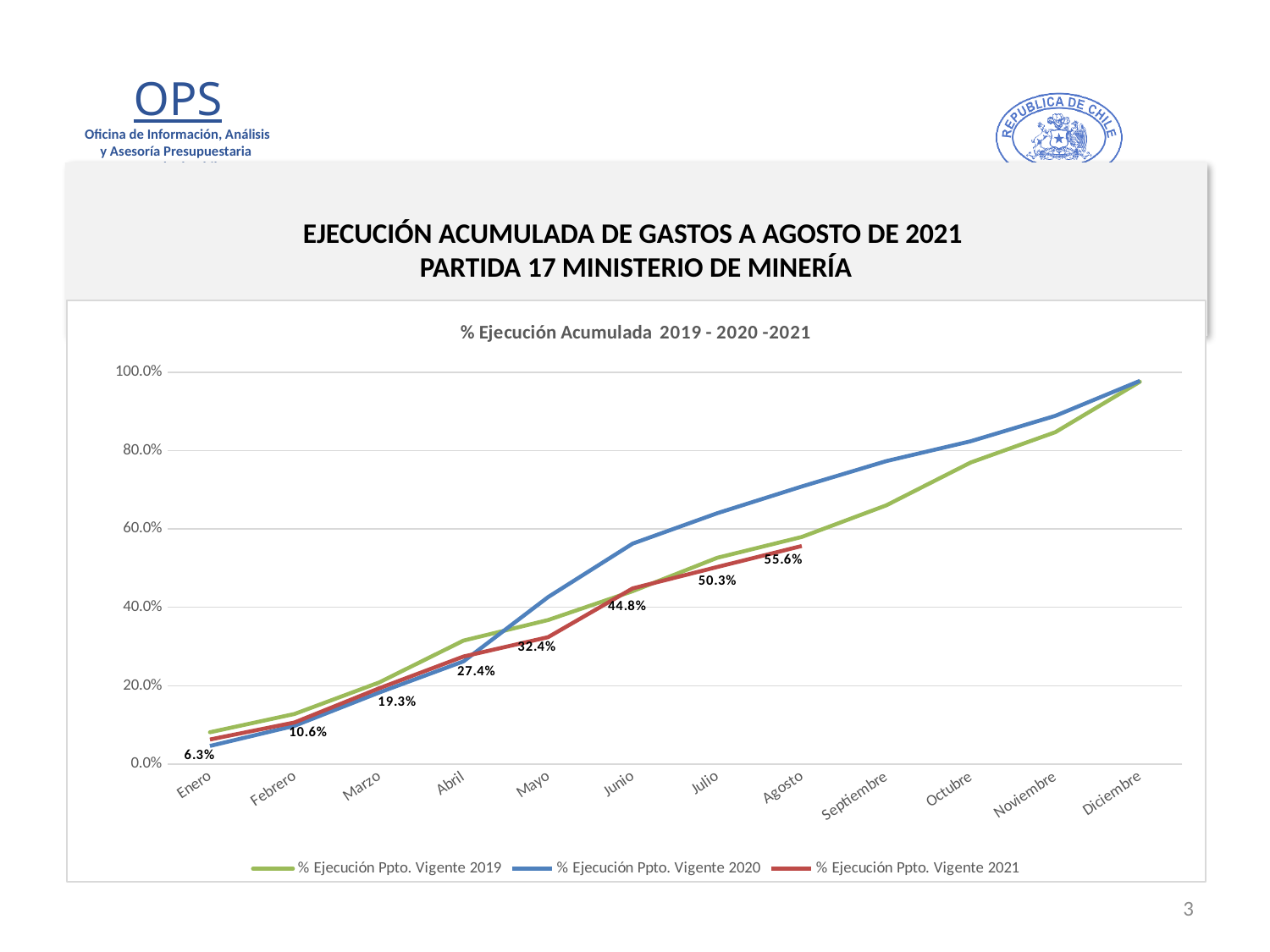
What is the difference between the 2021 values for Junio and Mayo? 12.4 percentage points What is the value for % Ejecución Ppto. Vigente 2021 in Marzo? 19.3% What is the value for % Ejecución Ppto. Vigente 2021 in Mayo? 32.4% What kind of chart is shown on the slide? Line chart Among the labelled 2021 values, which month has the highest value? Agosto Is the value for % Ejecución Ppto. Vigente 2020 in Junio greater or less than 40%? greater What is the value for % Ejecución Ppto. Vigente 2021 in Enero? 6.3% How many series does the legend list? 3 How many months are shown on the x axis? 12 By how many percentage points did % Ejecución Ppto. Vigente 2021 increase from Julio to Agosto? 5.3 percentage points In Junio, which series has the larger value: % Ejecución Ppto. Vigente 2020 or % Ejecución Ppto. Vigente 2019? % Ejecución Ppto. Vigente 2020 What is the value for % Ejecución Ppto. Vigente 2021 in Agosto? 55.6%